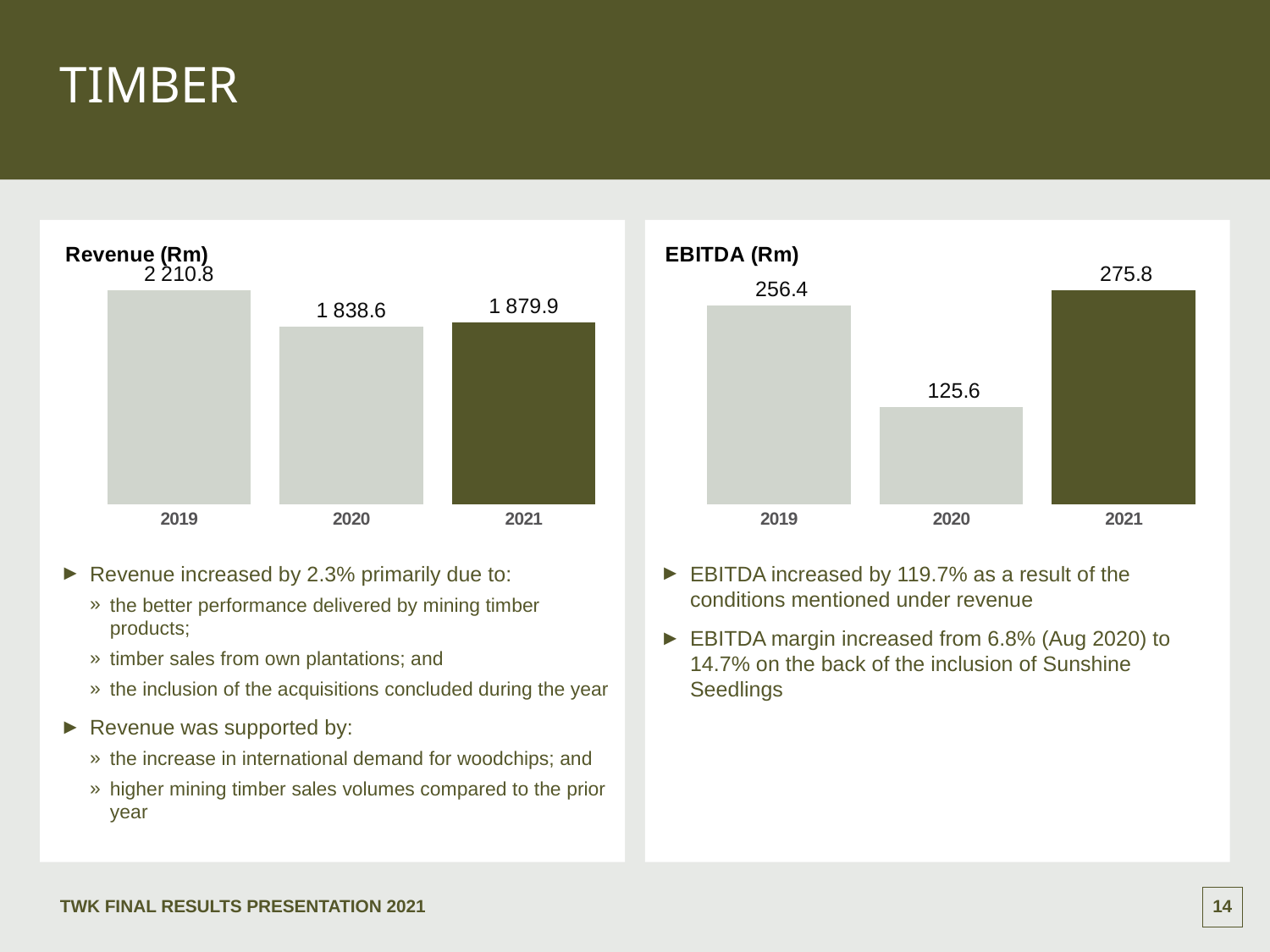
In the EBITDA (Rm) chart, what is the value for 2020? 125.6 In the Revenue (Rm) chart, which year has the highest value? 2019 In the Revenue (Rm) chart, what is the value for 2019? 2 210.8 How many years are shown in the EBITDA (Rm) chart? 3 In the EBITDA (Rm) chart, what is the value for 2021? 275.8 In the EBITDA (Rm) chart, does the value rise or fall from 2020 to 2021? Rise In the Revenue (Rm) chart, which is larger, the value for 2020 or the value for 2021? 2021 In the Revenue (Rm) chart, what is the value for 2021? 1 879.9 In the Revenue (Rm) chart, what is the difference between the 2019 and 2020 values? 372.2 In the EBITDA (Rm) chart, what is the difference between the 2021 and 2020 values? 150.2 What type of chart is the Revenue (Rm) chart? Bar chart In the EBITDA (Rm) chart, which year has the lowest value? 2020